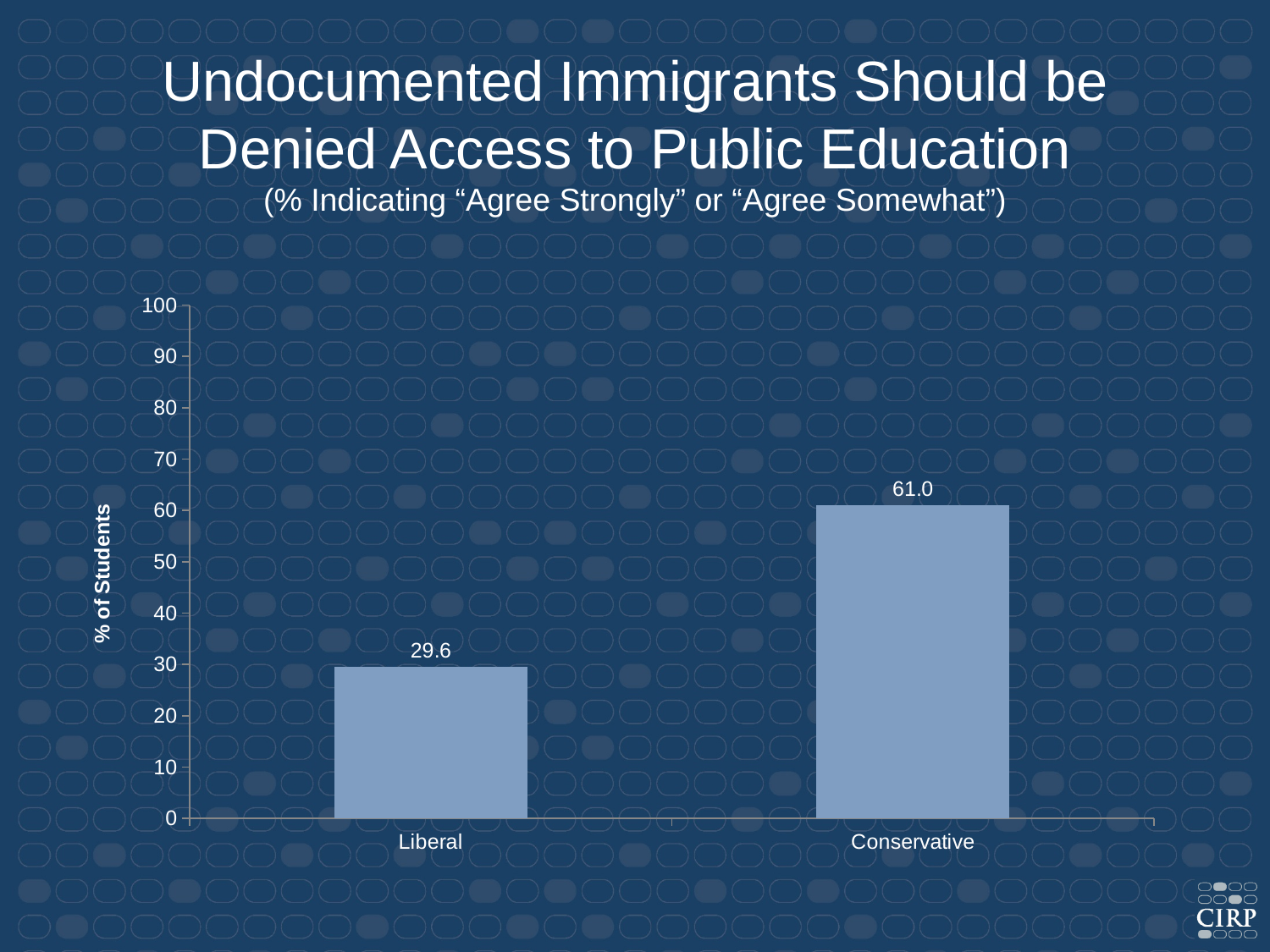
Which category has the lowest value? Liberal How many categories are shown on the x axis? 2 What is the value for Liberal? 29.6 Is the value for Conservative greater or less than 50? greater Is the value for Liberal greater or less than 40? less What is the value for Conservative? 61.0 What kind of chart is shown on the slide? bar chart Which category has the highest value? Conservative What is the label of the y axis? % of Students What is the difference between the values for Conservative and Liberal? 31.4 What is the maximum value shown on the y axis? 100 Which is larger, the value for Liberal or the value for Conservative? Conservative